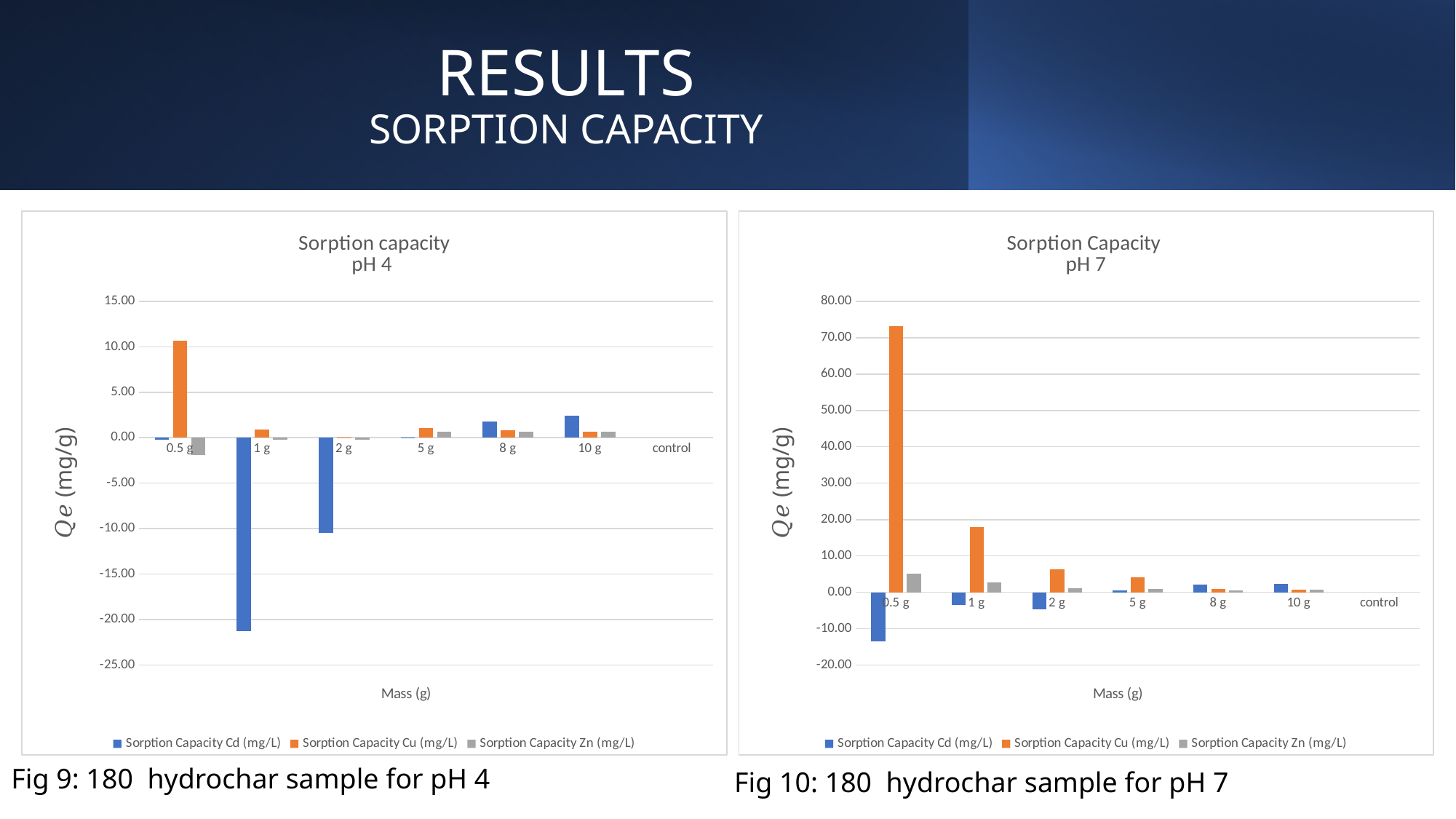
In the Sorption capacity pH 4 chart, at which mass is the Sorption Capacity Cu (mg/L) value highest? 0.5 g What kind of chart is the Sorption capacity pH 4 chart? bar chart In the Sorption Capacity pH 7 chart, is the Sorption Capacity Cu (mg/L) value at 1 g greater or less than 20.00? less What is the x-axis label of the Sorption Capacity pH 7 chart? Mass (g) In the Sorption capacity pH 4 chart, how many series does the legend list? 3 In the Sorption capacity pH 4 chart, how many mass categories are shown on the x axis? 7 In the Sorption Capacity pH 7 chart, is the Sorption Capacity Cu (mg/L) value at 0.5 g greater or less than 70.00? greater In the Sorption capacity pH 4 chart, is the Sorption Capacity Cu (mg/L) value at 0.5 g greater or less than 5.00? greater In the Sorption Capacity pH 7 chart, do the Sorption Capacity Cu (mg/L) values rise or fall from 0.5 g to 10 g? fall In the Sorption capacity pH 4 chart, at which mass is the Sorption Capacity Cd (mg/L) value lowest? 1 g